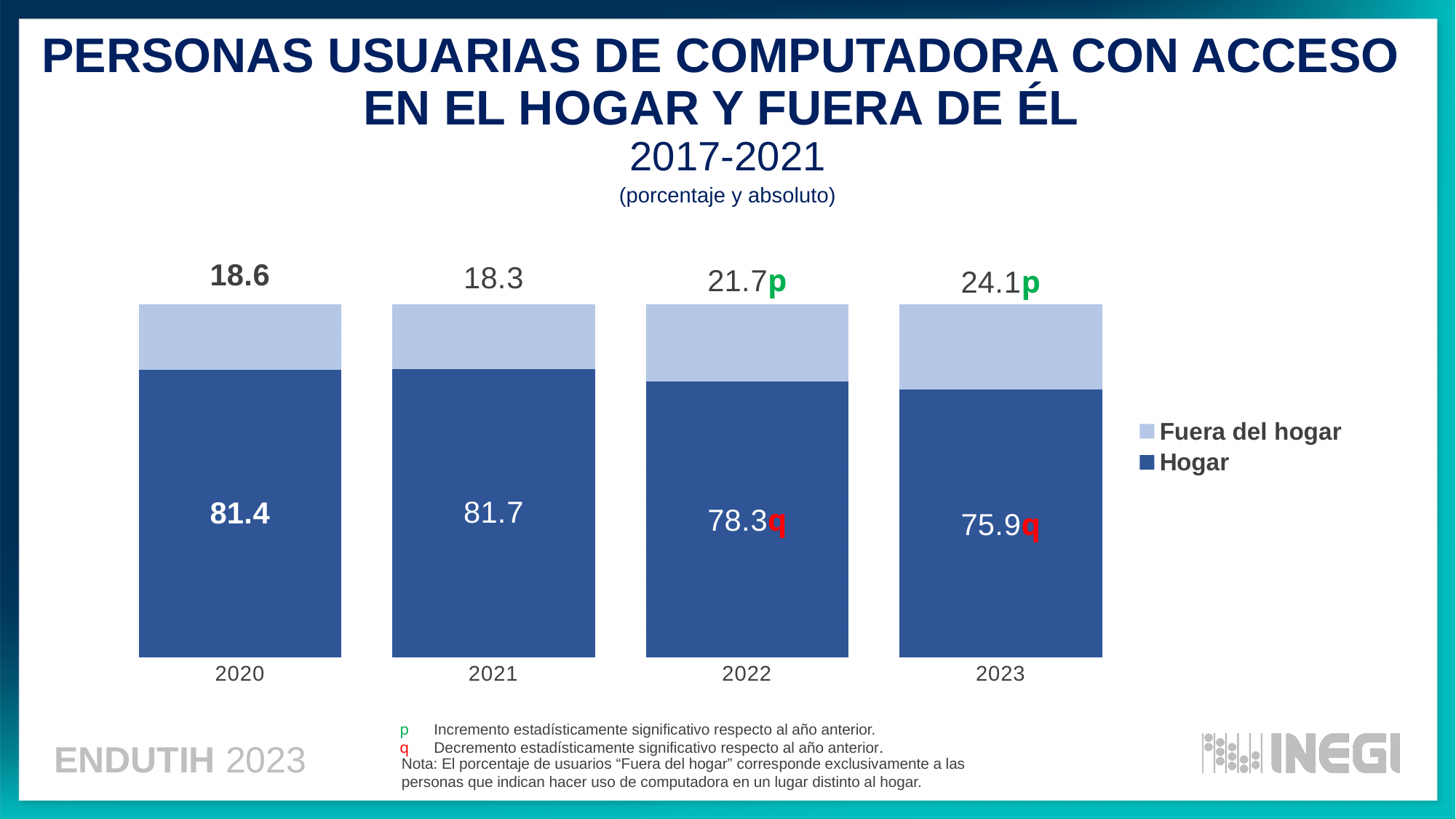
What kind of chart is shown on the slide? Stacked bar chart What is the value for Fuera del hogar in 2023? 24.1 Does the Fuera del hogar value rise or fall from 2021 to 2023? Rise What is the value for Fuera del hogar in 2021? 18.3 What is the difference between the Hogar values for 2020 and 2023? 5.5 Which is larger, the Fuera del hogar value for 2022 or for 2023? 2023 In which year is the Hogar value highest? 2021 What is the value for Hogar in 2020? 81.4 How many series does the legend list? 2 In which year is the Fuera del hogar value lowest? 2021 How many years are shown on the x axis? 4 What is the value for Hogar in 2022? 78.3